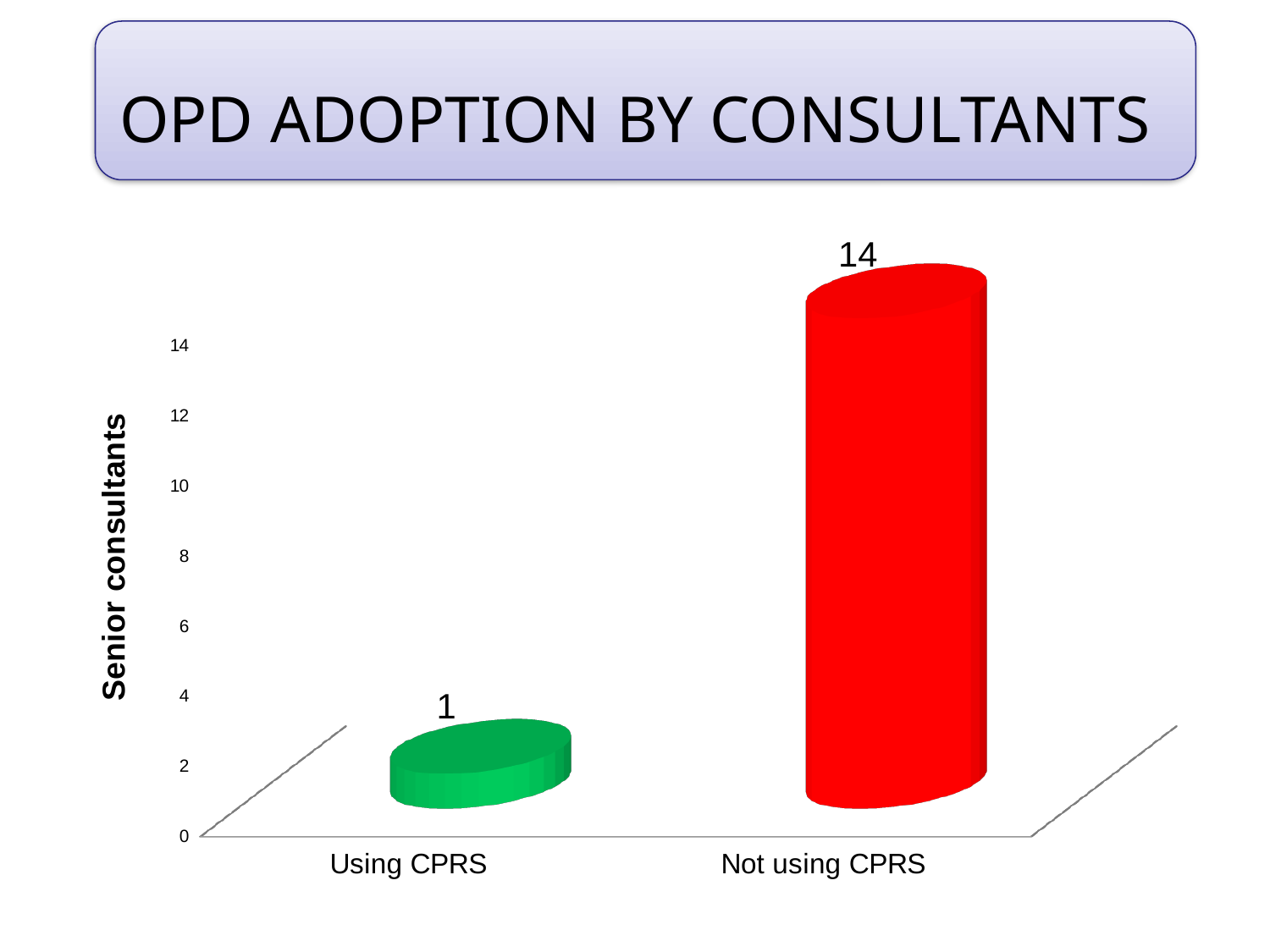
What colour is the bar for Not using CPRS? Red How many categories are shown on the x axis? 2 How many senior consultants are using CPRS? 1 Which category has the highest value? Not using CPRS What is the difference between the number of senior consultants not using CPRS and those using CPRS? 13 Which category has the lowest value? Using CPRS What kind of chart is shown on the slide? Bar chart What is the label of the vertical axis? Senior consultants How many senior consultants are not using CPRS? 14 Which is larger: the value for Using CPRS or the value for Not using CPRS? Not using CPRS Is the value for Not using CPRS greater or less than 10? greater Is the value for Using CPRS greater or less than 4? less